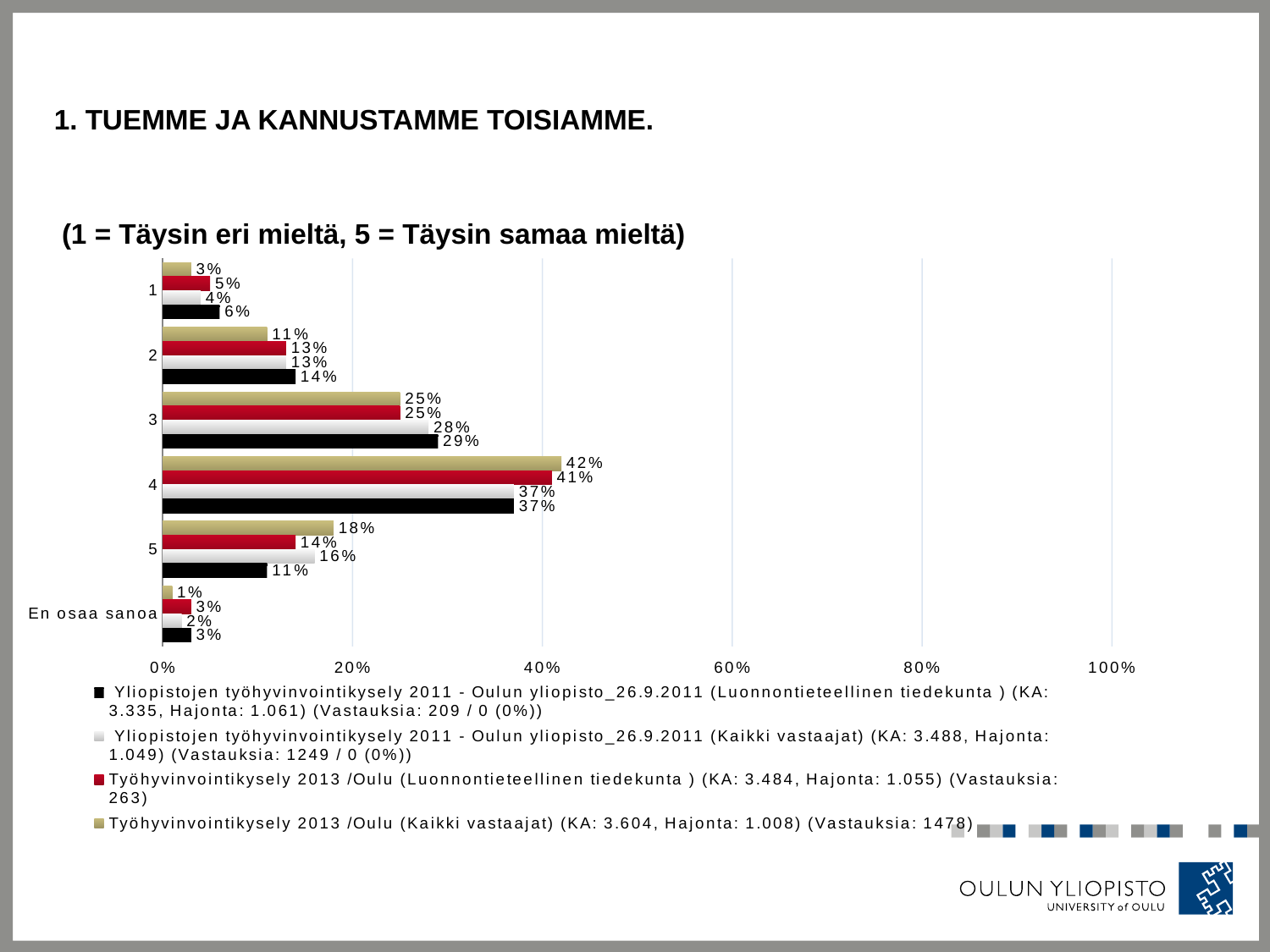
Which category has the lowest value in the Työhyvinvointikysely 2013 /Oulu (Kaikki vastaajat) series? En osaa sanoa What is the value for category 3 in the Ylioppistojen työhyvinvointikysely 2011 (Kaikki vastaajat) series? 28% How many categories are shown on the vertical axis? 6 What is the difference between the Työhyvinvointikysely 2013 /Oulu (Kaikki vastaajat) value and the Ylioppistojen työhyvinvointikysely 2011 (Luonnontieteellinen tiedekunta) value for category 5? 7% What is the value for 'En osaa sanoa' in the Työhyvinvointikysely 2013 /Oulu (Luonnontieteellinen tiedekunta) series? 3% What is the value for category 5 in the Ylioppistojen työhyvinvointikysely 2011 (Luonnontieteellinen tiedekunta) series? 11% What kind of chart is shown on the slide? bar chart Is the value for category 4 in the Työhyvinvointikysely 2013 /Oulu (Luonnontieteellinen tiedekunta) series greater or less than 40%? greater Which category has the highest value in the Työhyvinvointikysely 2013 /Oulu (Kaikki vastaajat) series? 4 How many series does the legend list? 4 What is the value for category 4 in the Työhyvinvointikysely 2013 /Oulu (Kaikki vastaajat) series? 42% For category 2, which is larger: the Työhyvinvointikysely 2013 /Oulu (Kaikki vastaajat) value or the Ylioppistojen työhyvinvointikysely 2011 (Luonnontieteellinen tiedekunta) value? Ylioppistojen työhyvinvointikysely 2011 (Luonnontieteellinen tiedekunta)